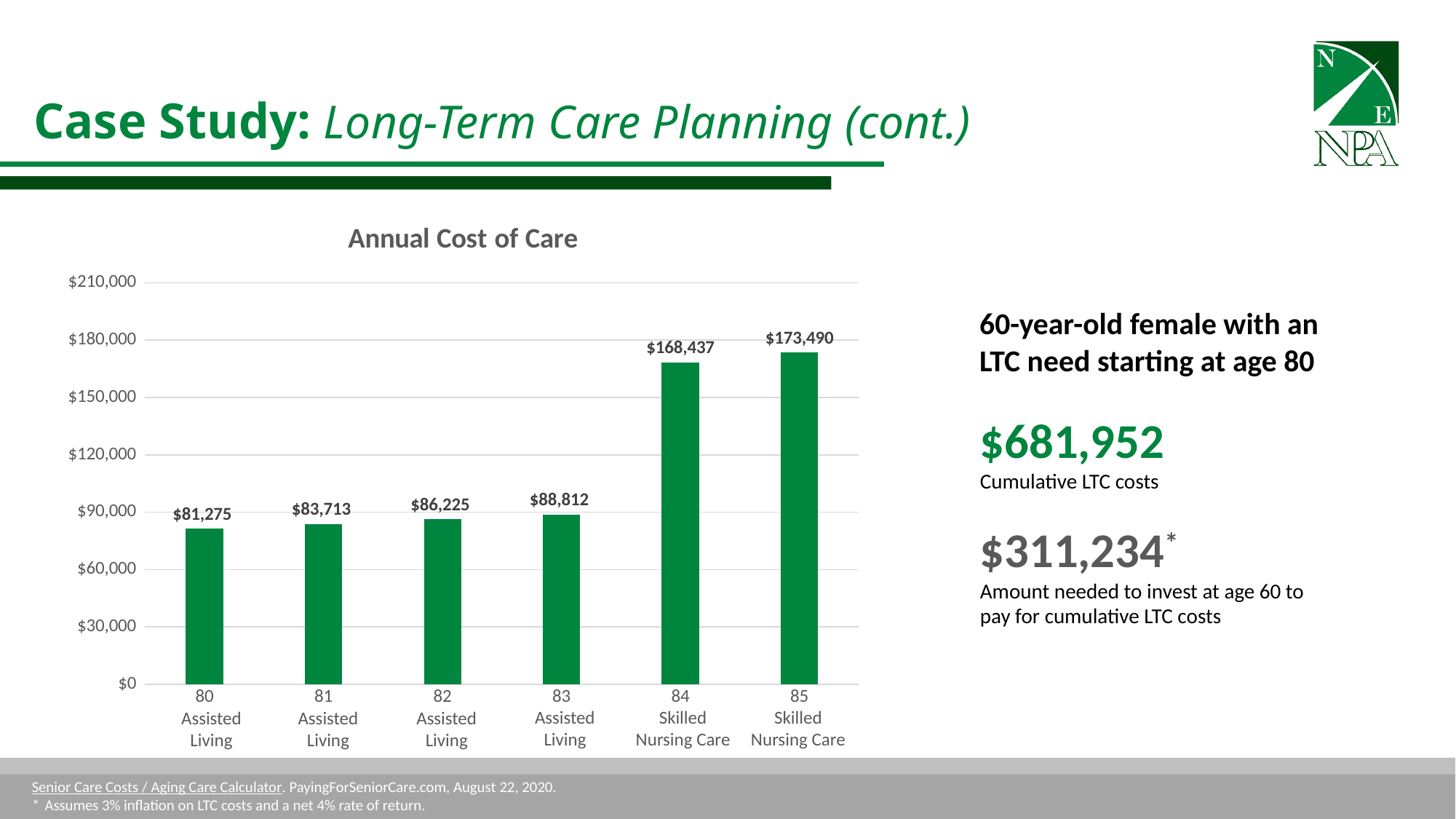
Which age has the highest annual cost of care? 85 What is the annual cost of care at age 84 (Skilled Nursing Care)? $168,437 What is the annual cost of care at age 82 (Assisted Living)? $86,225 Which age has the lowest annual cost of care? 80 What kind of chart is used to show the annual cost of care? bar chart How many age categories are shown in the chart? 6 What is the annual cost of care at age 80 (Assisted Living)? $81,275 Is the annual cost of care at age 81 greater or less than $90,000? less Do the annual cost of care values rise or fall from age 80 to age 85? rise Which is larger, the annual cost of care at age 84 or at age 83? 84 What is the difference between the annual cost of care at age 83 and at age 80? $7,537 What is the difference between the annual cost of care at age 85 and at age 84? $5,053